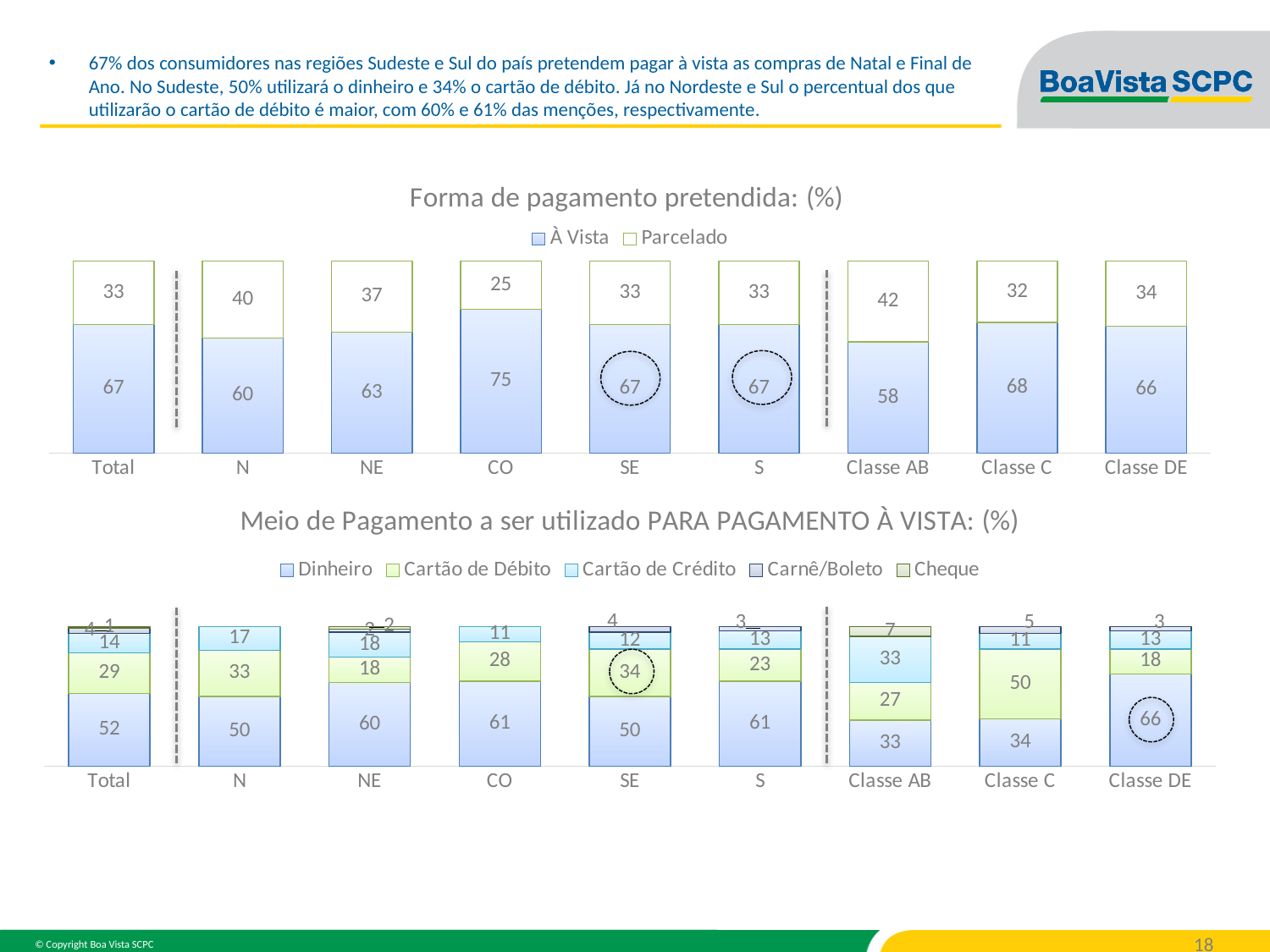
In the chart 'Forma de pagamento pretendida: (%)', which series is shown in blue? À Vista In the chart 'Meio de Pagamento a ser utilizado PARA PAGAMENTO À VISTA: (%)', how many series does the legend list? 5 What kind of chart is 'Meio de Pagamento a ser utilizado PARA PAGAMENTO À VISTA: (%)'? Stacked bar chart In the chart 'Forma de pagamento pretendida: (%)', which category has the highest À Vista value? CO In the chart 'Meio de Pagamento a ser utilizado PARA PAGAMENTO À VISTA: (%)', what is the Cartão de Débito value for Classe C? 50 In the chart 'Forma de pagamento pretendida: (%)', which category has the lowest À Vista value? Classe AB In the chart 'Forma de pagamento pretendida: (%)', what is the Parcelado value for Classe AB? 42 In the chart 'Meio de Pagamento a ser utilizado PARA PAGAMENTO À VISTA: (%)', which is larger for SE: Dinheiro or Cartão de Débito? Dinheiro In the chart 'Forma de pagamento pretendida: (%)', what is the À Vista value for CO? 75 In the chart 'Meio de Pagamento a ser utilizado PARA PAGAMENTO À VISTA: (%)', what is the Dinheiro value for Classe DE? 66 In the chart 'Forma de pagamento pretendida: (%)', what is the difference between the À Vista values for CO and N? 15 In the chart 'Forma de pagamento pretendida: (%)', how many categories are shown on the x axis? 9